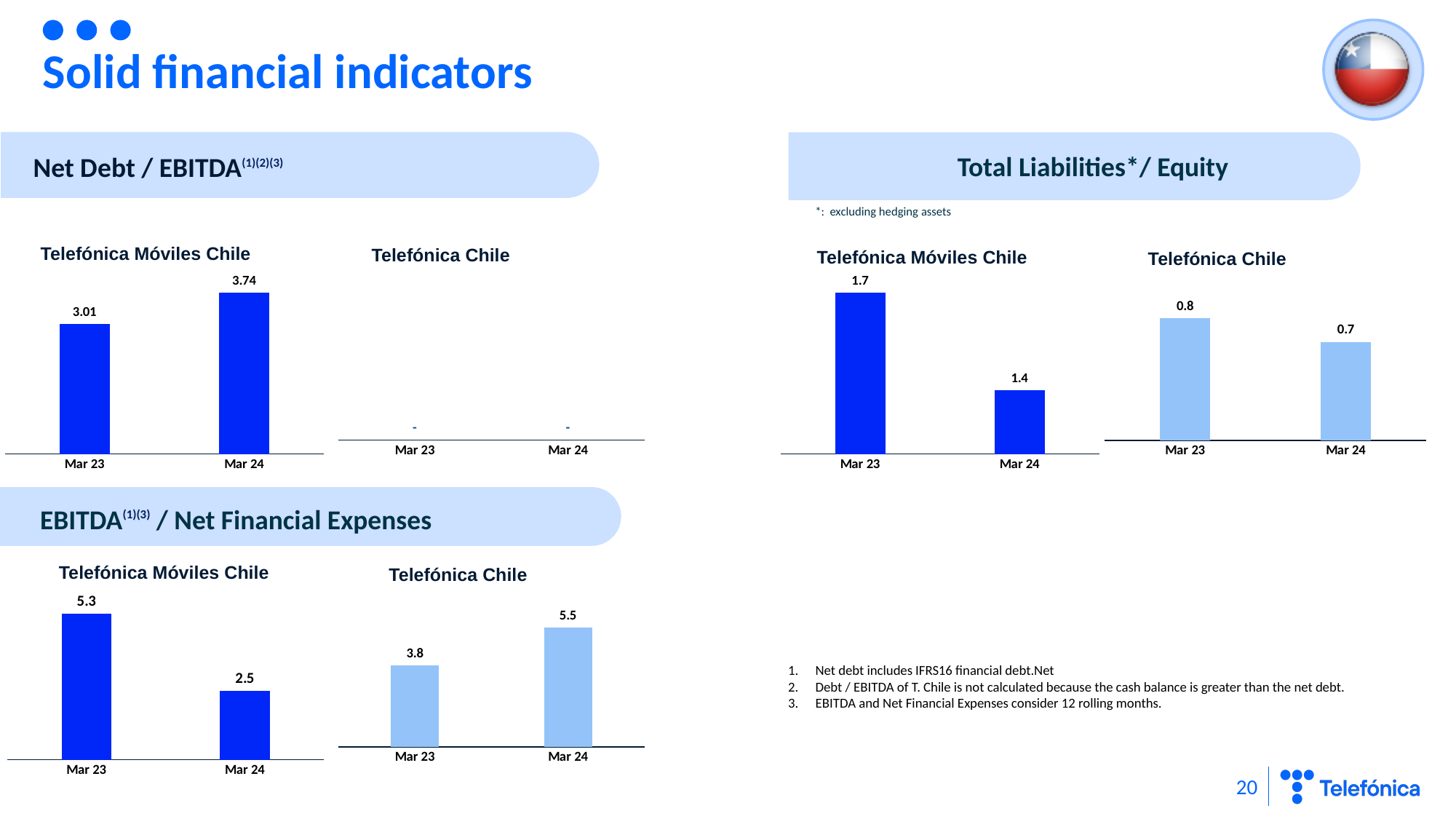
In the Total Liabilities / Equity chart for Telefónica Chile, which period has the higher value? Mar 23 In the Net Debt / EBITDA chart for Telefónica Móviles Chile, does the value rise or fall from Mar 23 to Mar 24? rise In the Total Liabilities / Equity chart for Telefónica Chile, what is the value for Mar 24? 0.7 In the EBITDA / Net Financial Expenses chart for Telefónica Móviles Chile, what is the value for Mar 23? 5.3 What kind of chart is used for the Net Debt / EBITDA chart for Telefónica Móviles Chile? bar chart In the Total Liabilities / Equity chart for Telefónica Móviles Chile, what is the difference between Mar 23 and Mar 24? 0.3 In the EBITDA / Net Financial Expenses chart for Telefónica Chile, does the value rise or fall from Mar 23 to Mar 24? rise In the Total Liabilities / Equity chart for Telefónica Móviles Chile, what is the value for Mar 23? 1.7 In the Net Debt / EBITDA chart for Telefónica Móviles Chile, what is the value for Mar 24? 3.74 In the EBITDA / Net Financial Expenses chart for Telefónica Chile, what is the value for Mar 24? 5.5 In the Net Debt / EBITDA chart for Telefónica Móviles Chile, what is the value for Mar 23? 3.01 In the EBITDA / Net Financial Expenses chart for Telefónica Móviles Chile, what is the difference between Mar 23 and Mar 24? 2.8